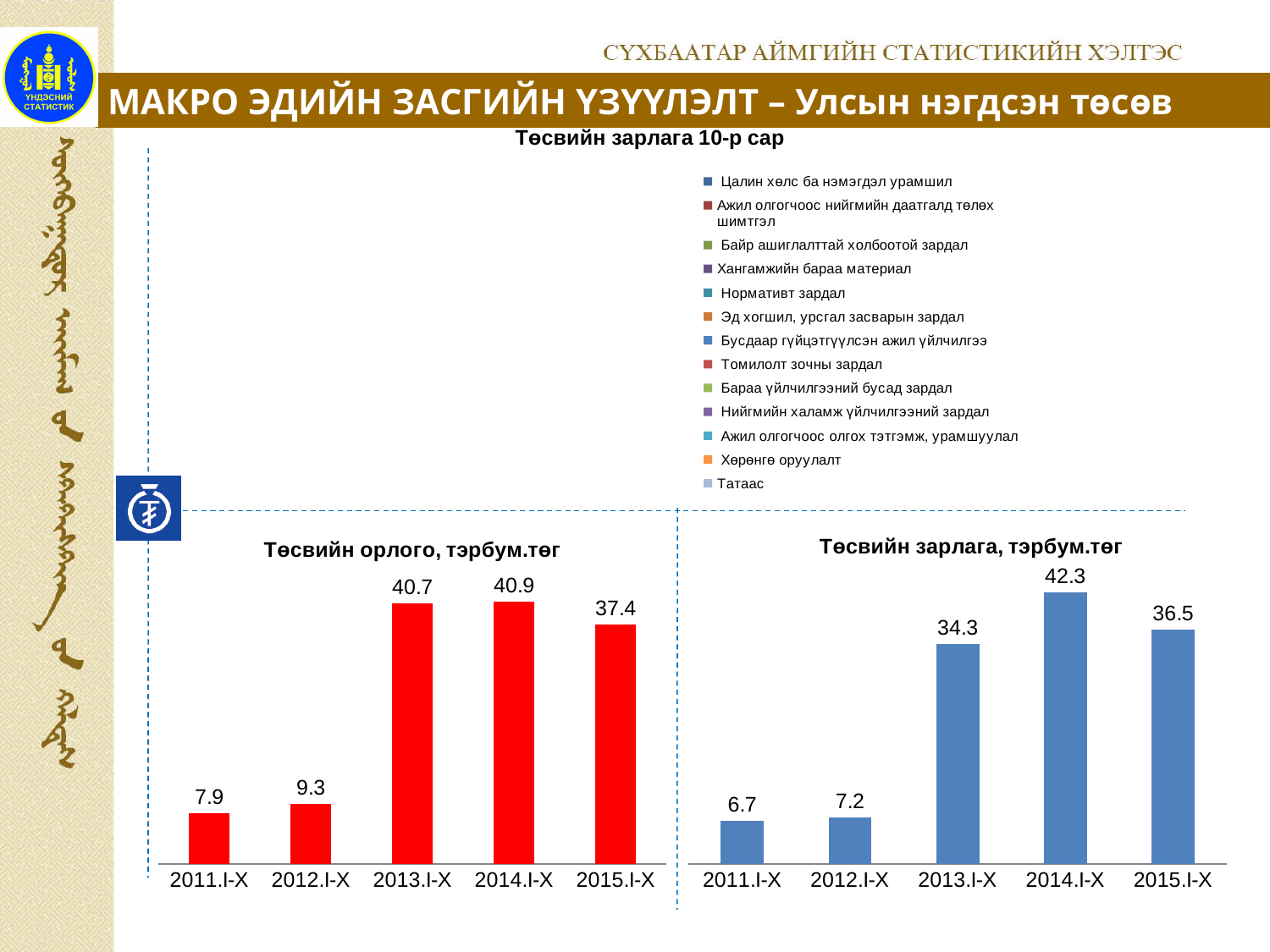
In the chart titled 'Төсвийн зарлага, тэрбум.төг', what is the value for 2014.I-X? 42.3 In the chart titled 'Төсвийн орлого, тэрбум.төг', which period has the highest value? 2014.I-X In the chart titled 'Төсвийн зарлага, тэрбум.төг', what is the difference between the values for 2014.I-X and 2013.I-X? 8.0 In the chart titled 'Төсвийн орлого, тэрбум.төг', what is the difference between the values for 2014.I-X and 2015.I-X? 3.5 In the chart titled 'Төсвийн зарлага, тэрбум.төг', do the values rise or fall from 2011.I-X to 2014.I-X? Rise In the chart titled 'Төсвийн орлого, тэрбум.төг', what is the value for 2013.I-X? 40.7 What kind of chart is the chart titled 'Төсвийн зарлага, тэрбум.төг'? Bar chart In the chart titled 'Төсвийн зарлага, тэрбум.төг', which is larger, the value for 2013.I-X or 2015.I-X? 2015.I-X How many periods are shown on the x axis of the chart titled 'Төсвийн орлого, тэрбум.төг'? 5 What colour are the bars in the chart titled 'Төсвийн орлого, тэрбум.төг'? Red In the chart titled 'Төсвийн зарлага, тэрбум.төг', which period has the lowest value? 2011.I-X In the chart titled 'Төсвийн орлого, тэрбум.төг', which is larger, the value for 2011.I-X or 2012.I-X? 2012.I-X